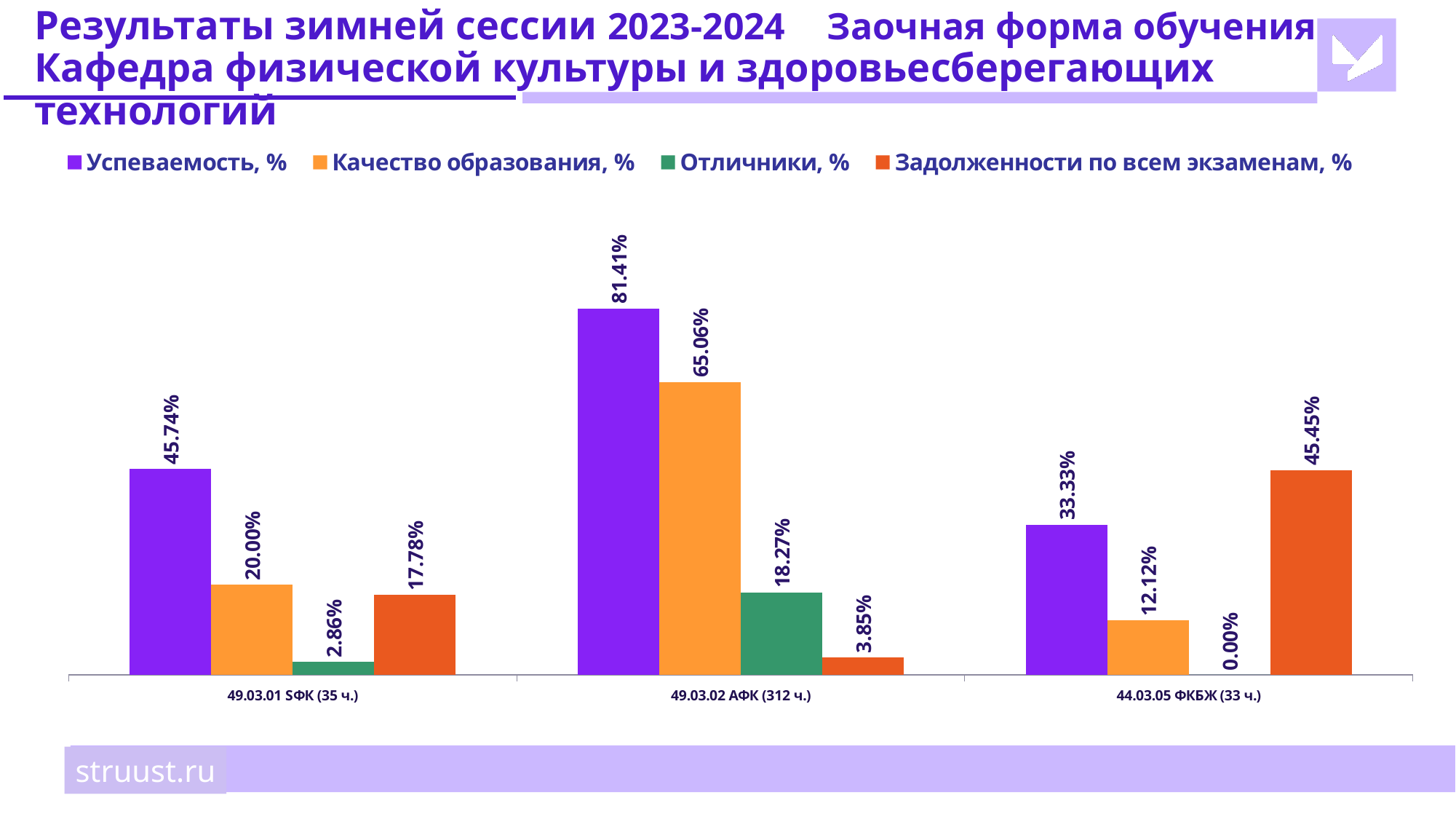
What is the value of Успеваемость, % for 49.03.02 АФК (312 ч.)? 81.41% What is the value of Задолженности по всем экзаменам, % for 44.03.05 ФКБЖ (33 ч.)? 45.45% Which colour represents Отличники, % in the legend? Green What is the value of Качество образования, % for 44.03.05 ФКБЖ (33 ч.)? 12.12% How many series does the legend list? 4 What is the difference between Успеваемость, % and Качество образования, % for 49.03.02 АФК (312 ч.)? 16.35% What is the value of Отличники, % for 49.03.01 (35 ч.)? 2.86% How many categories are shown on the x axis? 3 Which category has the highest value of Успеваемость, %? 49.03.02 АФК (312 ч.) Which is larger for 44.03.05 ФКБЖ (33 ч.): Успеваемость, % or Задолженности по всем экзаменам, %? Задолженности по всем экзаменам, % What kind of chart is shown on the slide? Bar chart Which category has the lowest value of Отличники, %? 44.03.05 ФКБЖ (33 ч.)